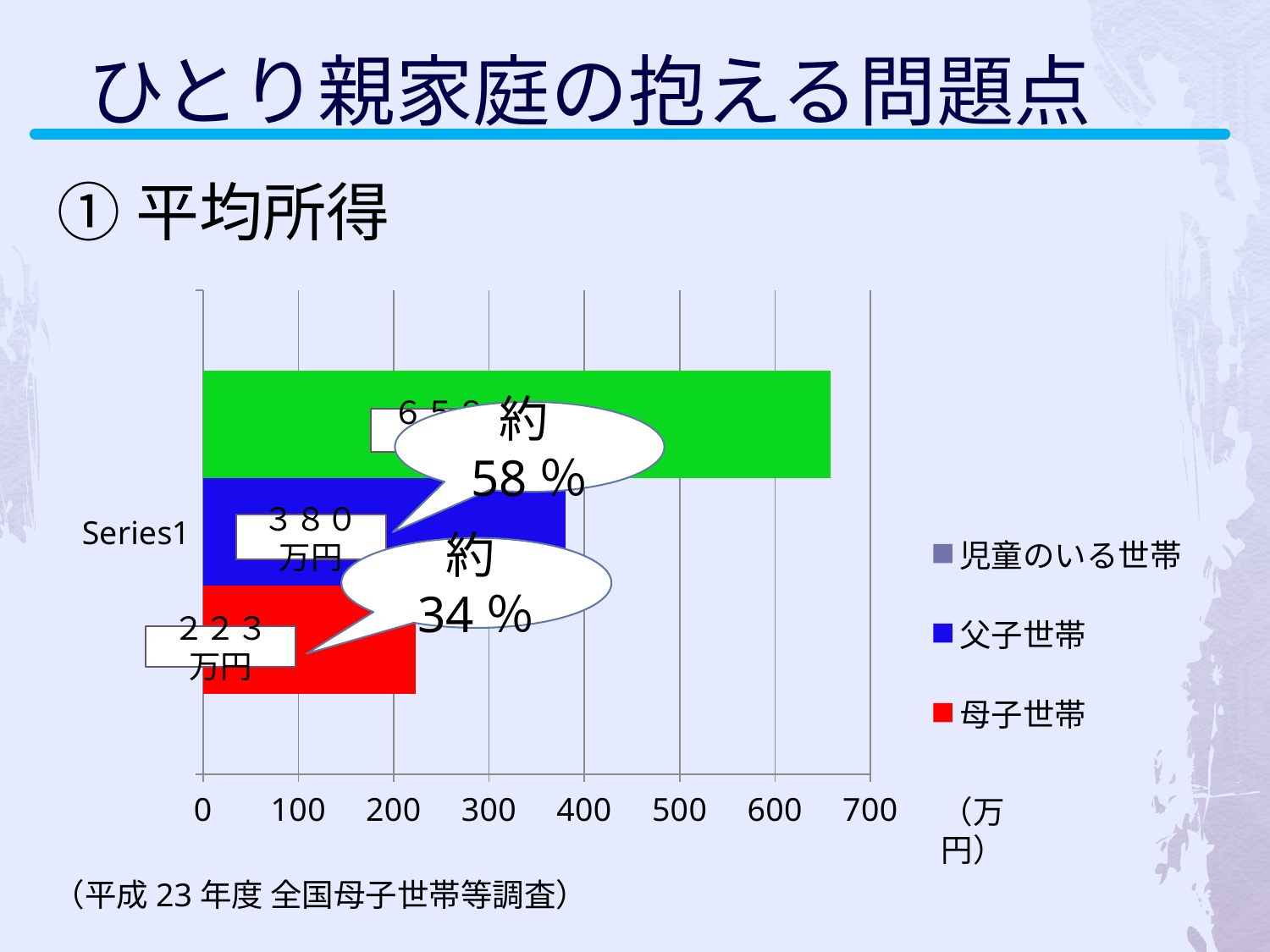
Which is larger, the value for 父子世帯 or the value for 母子世帯? 父子世帯 Is the value for 母子世帯 greater or less than 300? less Is the value for 児童のいる世帯 greater or less than 600? greater What type of chart is shown on the slide? bar chart Which series has the lowest value? 母子世帯 What is the difference between the values for 父子世帯 and 母子世帯? 157万円 What is the value shown for 母子世帯? ２２３万円 What is the value shown for 父子世帯? ３８０万円 Which series has the highest value? 児童のいる世帯 What percentage is written in the callout pointing to the 母子世帯 bar? 約34％ What unit is shown at the end of the horizontal axis? 万円 How many series does the legend list? 3